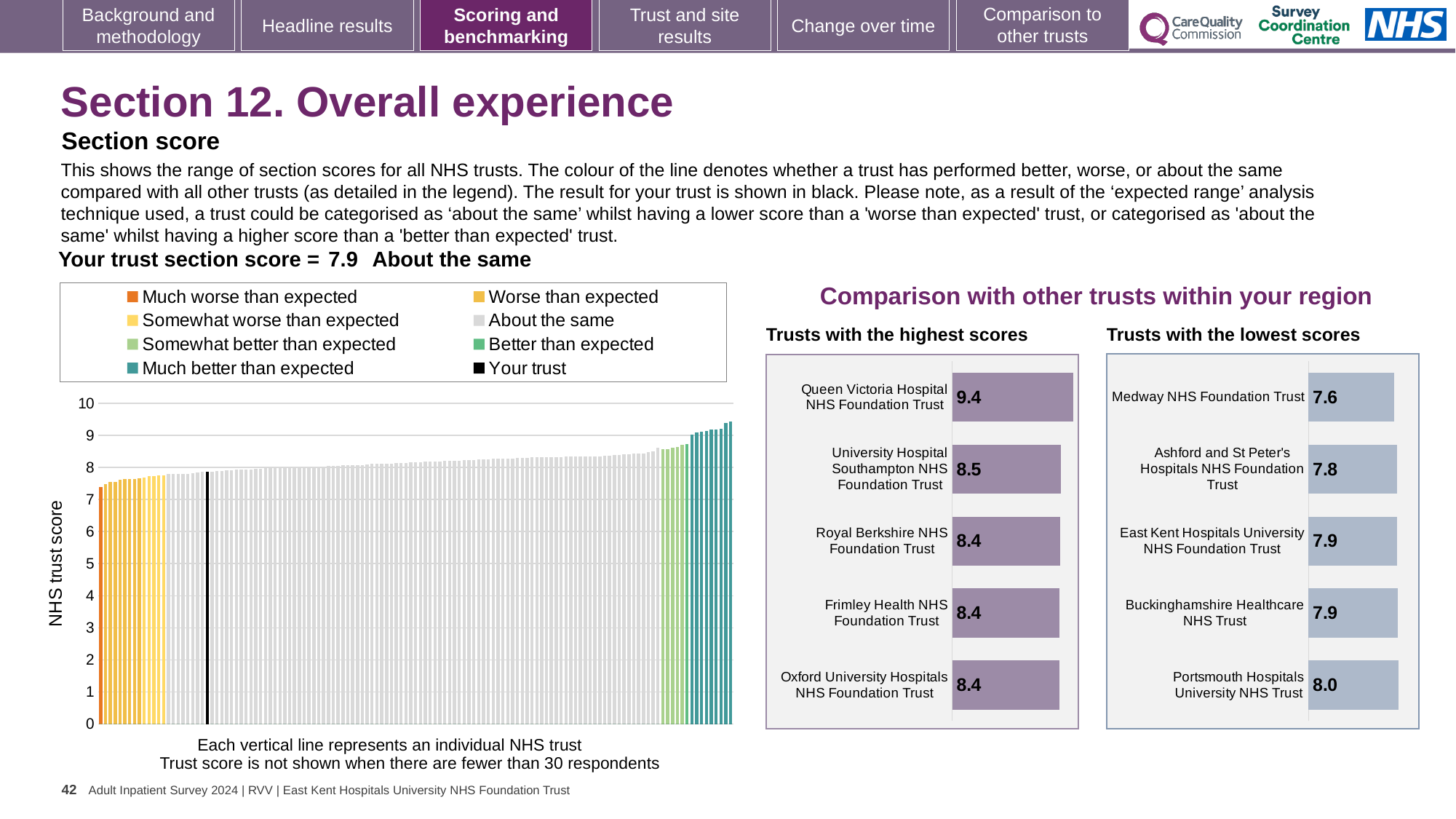
In the 'Trusts with the highest scores' chart, which trust has the highest score? Queen Victoria Hospital NHS Foundation Trust How many entries does the legend of the main 'NHS trust score' chart list? 8 In the 'Trusts with the lowest scores' chart, what is the score for Portsmouth Hospitals University NHS Trust? 8.0 In the 'Trusts with the lowest scores' chart, what is the difference between the scores of Portsmouth Hospitals University NHS Trust and Medway NHS Foundation Trust? 0.4 In the 'Trusts with the highest scores' chart, what is the score for Queen Victoria Hospital NHS Foundation Trust? 9.4 In the main 'NHS trust score' chart, do the values rise or fall from left to right along the x axis? rise In the 'Trusts with the lowest scores' chart, which has the larger score: Ashford and St Peter's Hospitals NHS Foundation Trust or Medway NHS Foundation Trust? Ashford and St Peter's Hospitals NHS Foundation Trust In the 'Trusts with the highest scores' chart, what is the score for University Hospital Southampton NHS Foundation Trust? 8.5 In the 'Trusts with the highest scores' chart, what is the difference between the scores of Queen Victoria Hospital NHS Foundation Trust and University Hospital Southampton NHS Foundation Trust? 0.9 How many trusts are shown in the 'Trusts with the highest scores' chart? 5 In the 'Trusts with the lowest scores' chart, what is the score for Medway NHS Foundation Trust? 7.6 In the 'Trusts with the lowest scores' chart, which trust has the lowest score? Medway NHS Foundation Trust